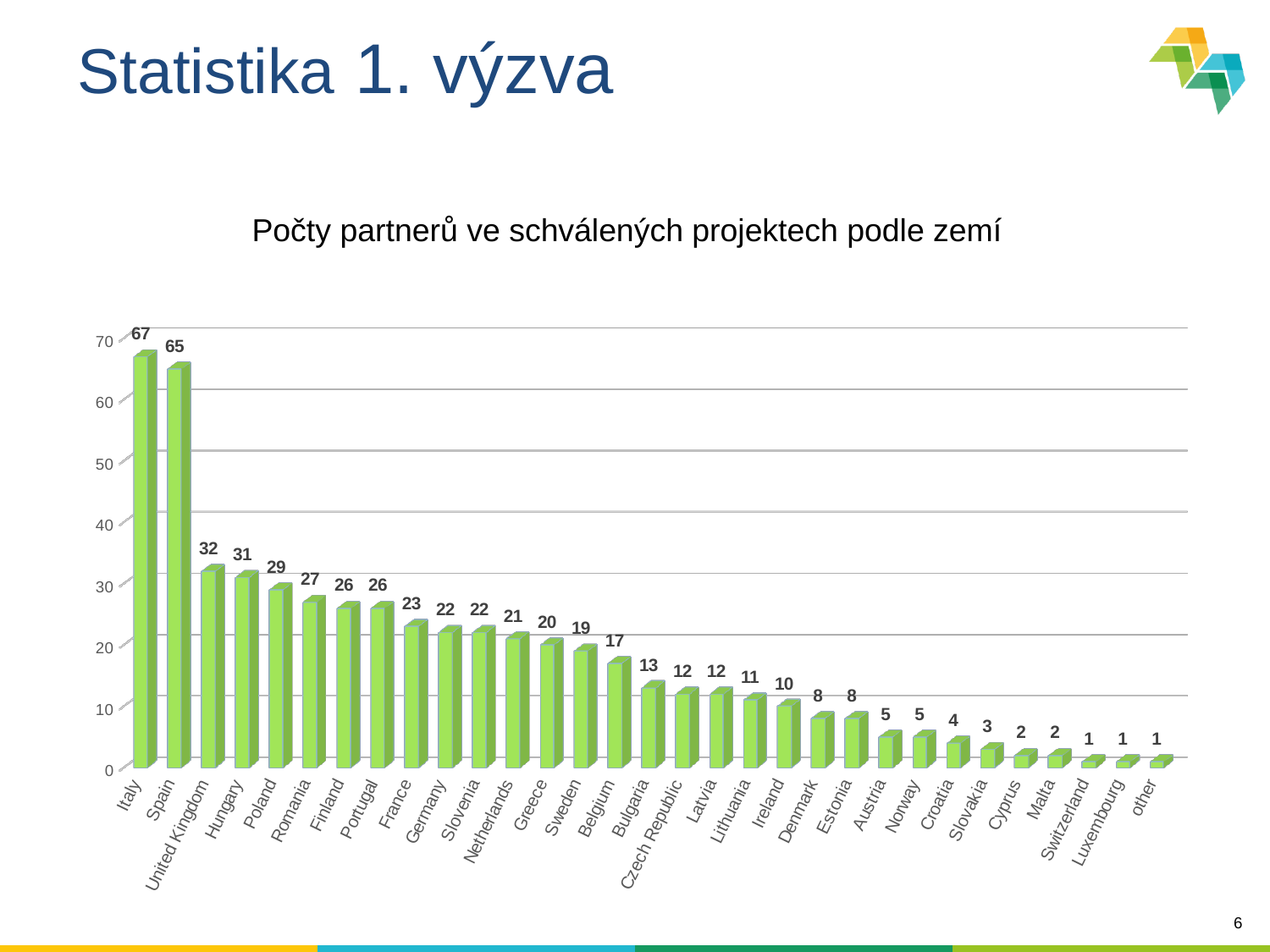
What kind of chart is shown on the slide? bar chart How many partners does Italy have in the chart? 67 What is the value shown for the Czech Republic? 12 How many categories are shown on the x axis of the chart? 31 Do the values rise or fall from left to right along the x axis? fall What is the difference between the values for United Kingdom and Poland? 3 Which country has the highest number of partners? Italy Which has a larger value, Hungary or Romania? Hungary What is the difference between the values for Italy and Spain? 2 What is the title of the chart? Počty partnerů ve schválených projektech podle zemí What is the value shown for Germany? 22 Which has a larger value, Belgium or Bulgaria? Belgium